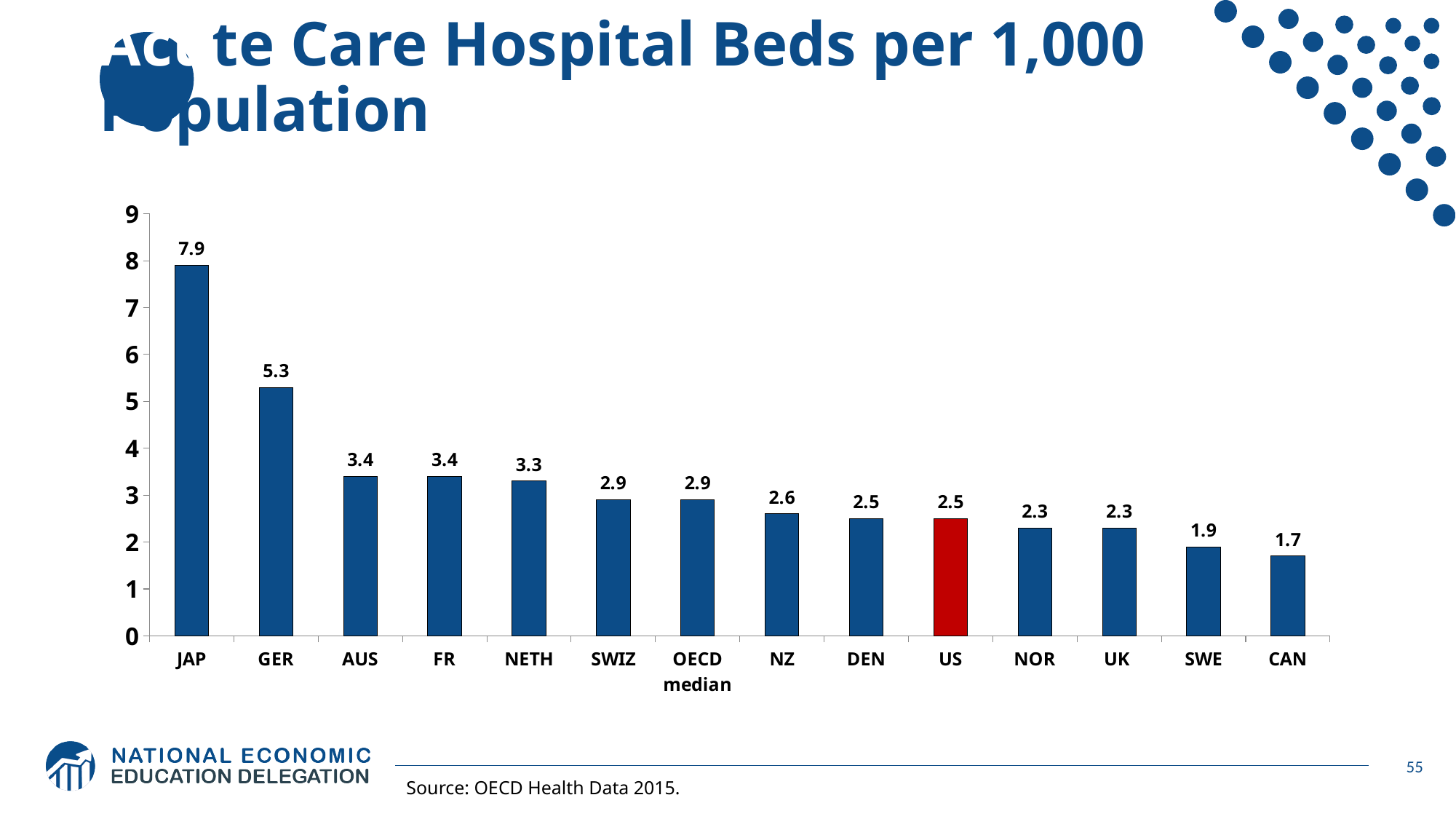
Which bar is coloured red? US What is the value for the OECD median? 2.9 Is the value for NETH greater or less than 3? greater Which category has the lowest value? CAN What kind of chart is shown on the slide? bar chart Which is larger, the value for GER or the value for AUS? GER What is the difference between the values for JAP and GER? 2.6 Which category has the highest value? JAP What is the value for US? 2.5 What is the difference between the values for the OECD median and US? 0.4 How many categories are shown on the x axis? 14 What is the value for JAP? 7.9